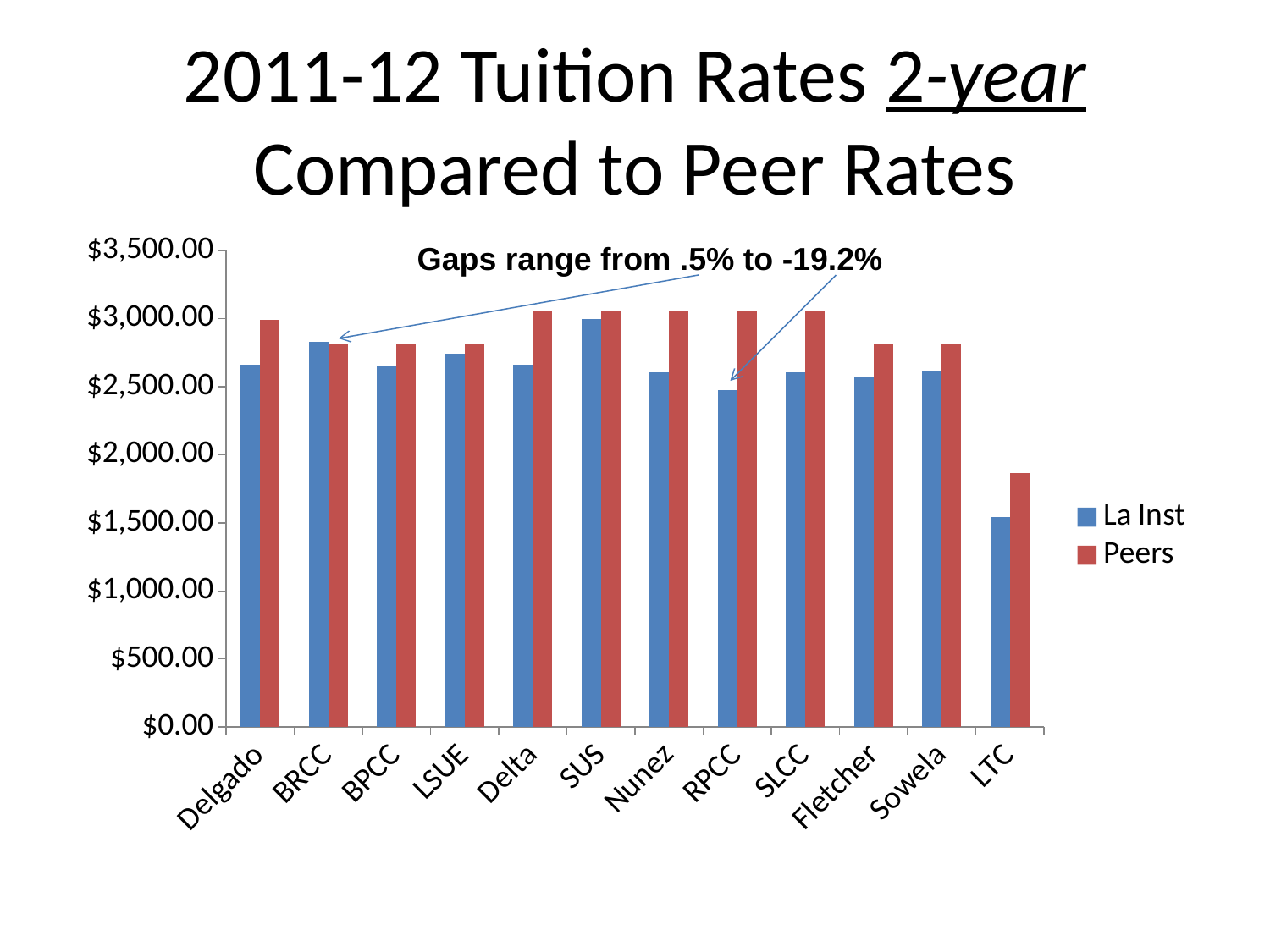
For LTC, which is larger: the La Inst rate or the Peers rate? Peers How many series does the chart's legend list? 2 What kind of chart is shown on the slide? Bar chart Is the La Inst value for LTC greater or less than $2,000.00? less How many institutions are shown on the x axis of the chart? 12 Which institution has the highest La Inst tuition rate? SUS Which institution has the lowest Peers tuition rate? LTC For RPCC, which is larger: the La Inst rate or the Peers rate? Peers Which institution has the lowest La Inst tuition rate? LTC Is the La Inst value for Delgado greater or less than $2,500.00? greater According to the annotation on the chart, what range do the gaps cover? .5% to -19.2%